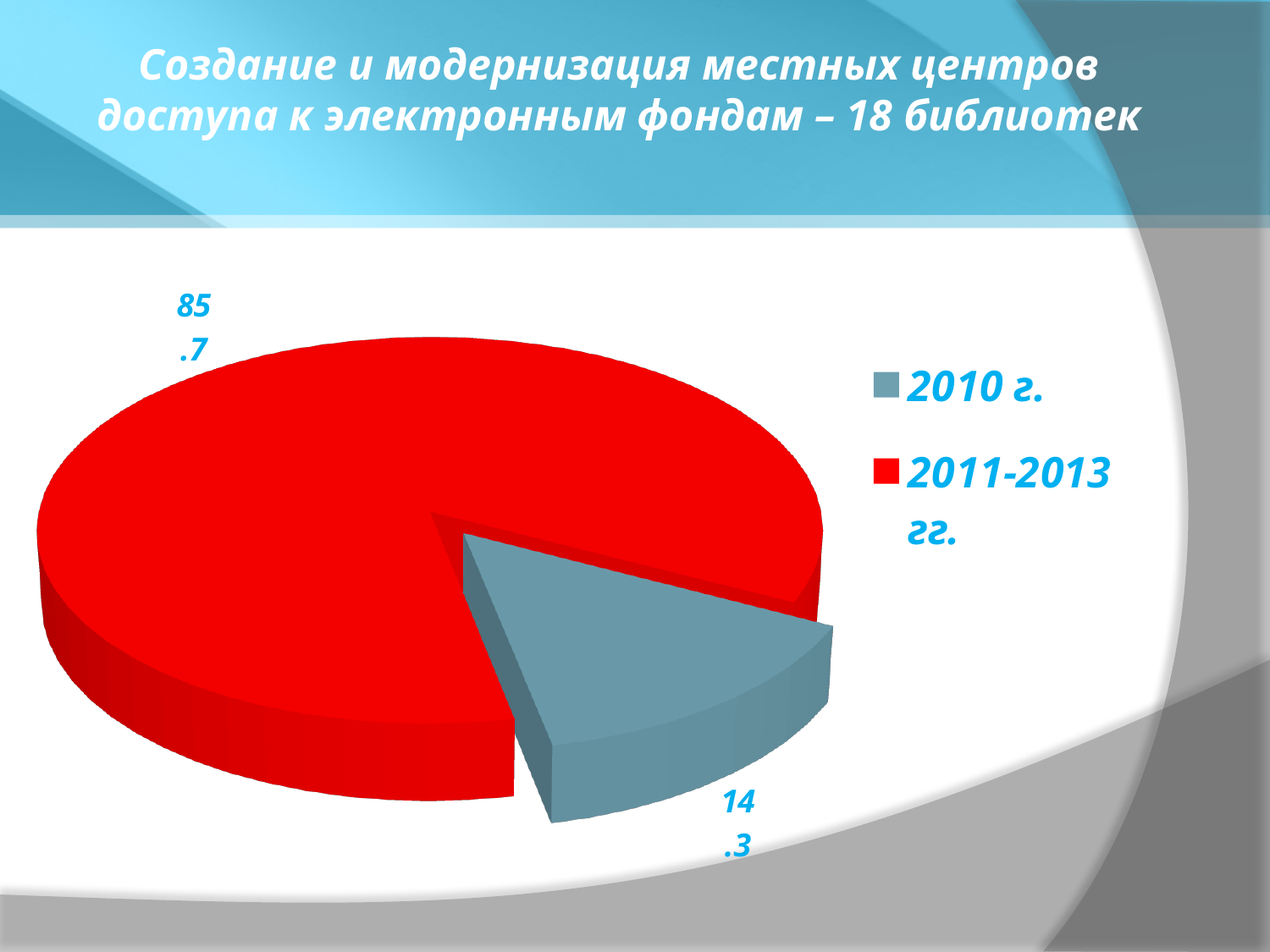
Which is larger, the slice for 2010 г. or the slice for 2011-2013 гг.? 2011-2013 гг. What is the difference between the values for 2011-2013 гг. and 2010 г.? 71.4 Which slice is the smallest in the pie chart? 2010 г. How many entries does the legend list? 2 Which slice is the largest in the pie chart? 2011-2013 гг. How many slices does the pie chart have? 2 What is the value shown for the 2010 г. slice? 14.3 What colour is the slice for 2010 г.? grey-blue What colour is the slice for 2011-2013 гг.? red What is the value shown for the 2011-2013 гг. slice? 85.7 What is the total of the two slice values shown on the chart? 100 What kind of chart is shown on the slide? pie chart